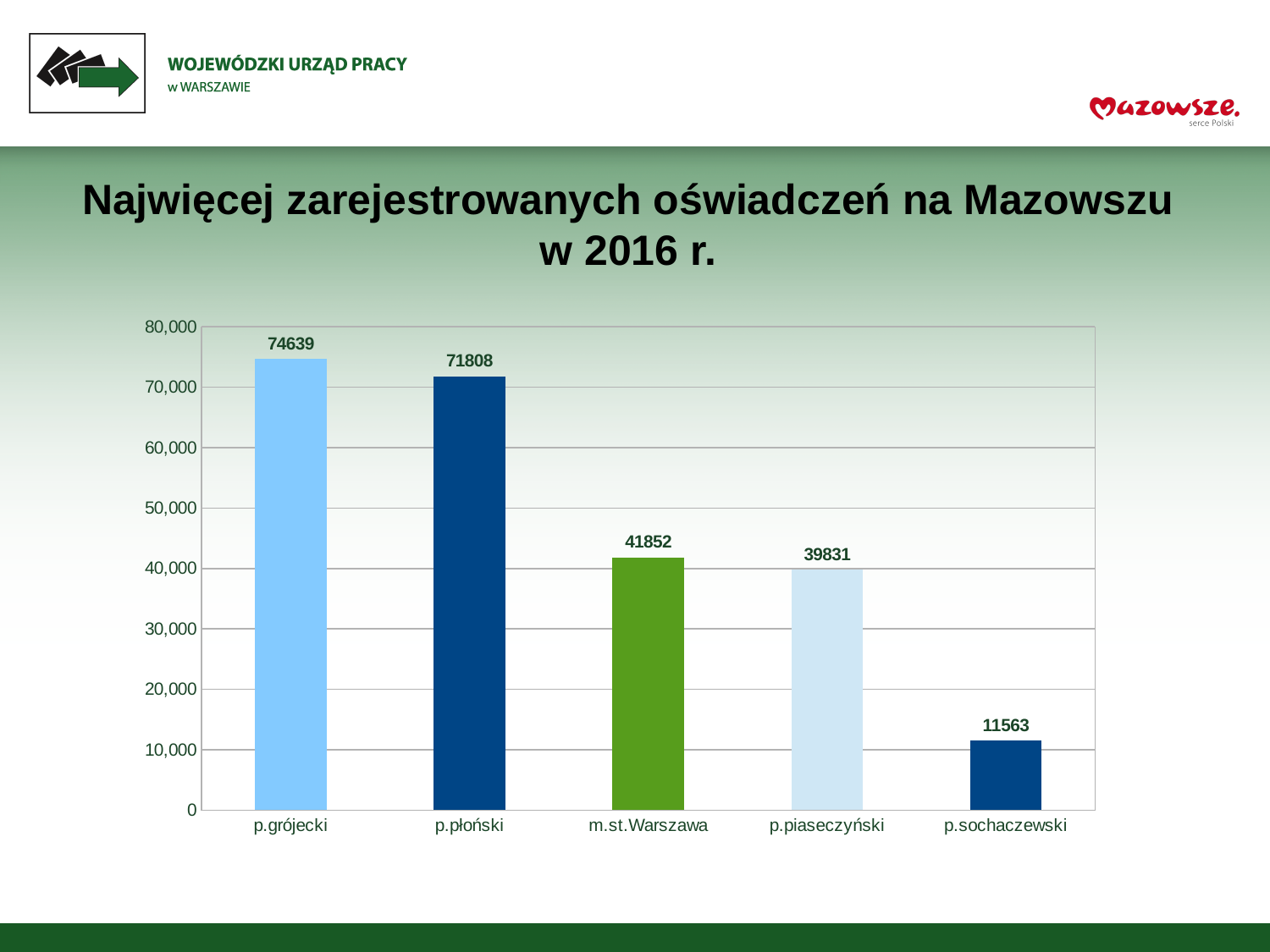
What is the difference between the values for p.grójecki and p.płoński? 2831 What is the value for p.sochaczewski? 11563 Do the values rise or fall from left to right along the x axis? fall Is the value for m.st.Warszawa greater or less than 40,000? greater Which category has the highest value? p.grójecki What is the value for p.grójecki? 74639 What is the difference between the values for m.st.Warszawa and p.piaseczyński? 2021 Which is larger, the value for p.płoński or the value for m.st.Warszawa? p.płoński Which category has the lowest value? p.sochaczewski How many categories are shown on the x axis? 5 What is the value for m.st.Warszawa? 41852 What kind of chart is shown on the slide? bar chart